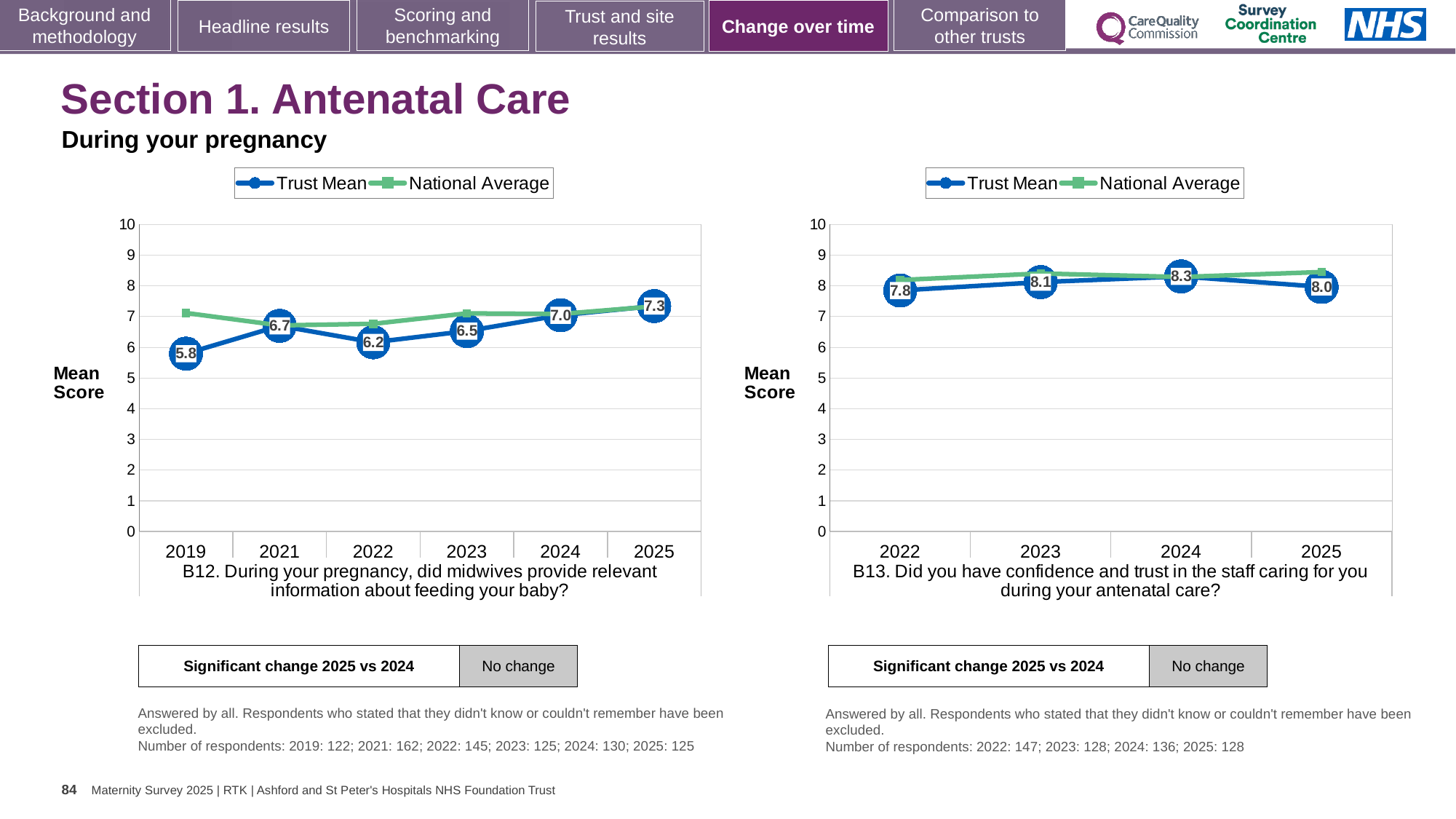
What kind of chart is the B13 chart (right)? Line chart In the B12 chart (left), what is the Trust Mean score for 2019? 5.8 In the B12 chart (left), which year has the larger Trust Mean score, 2021 or 2022? 2021 In the B12 chart (left), which year has the lowest Trust Mean score? 2019 How many years are plotted on the x axis of the B13 chart (right)? 4 How many series does the legend of the B12 chart (left) list? 2 In the B13 chart (right), which year has the highest Trust Mean score? 2024 In the B12 chart (left), what is the Trust Mean score for 2025? 7.3 In the B13 chart (right), what is the difference between the Trust Mean scores for 2024 and 2025? 0.3 In the B12 chart (left), what is the difference between the Trust Mean scores for 2025 and 2019? 1.5 In the B13 chart (right), what is the Trust Mean score for 2024? 8.3 In the B12 chart (left), is the National Average for 2019 greater or less than 6? greater